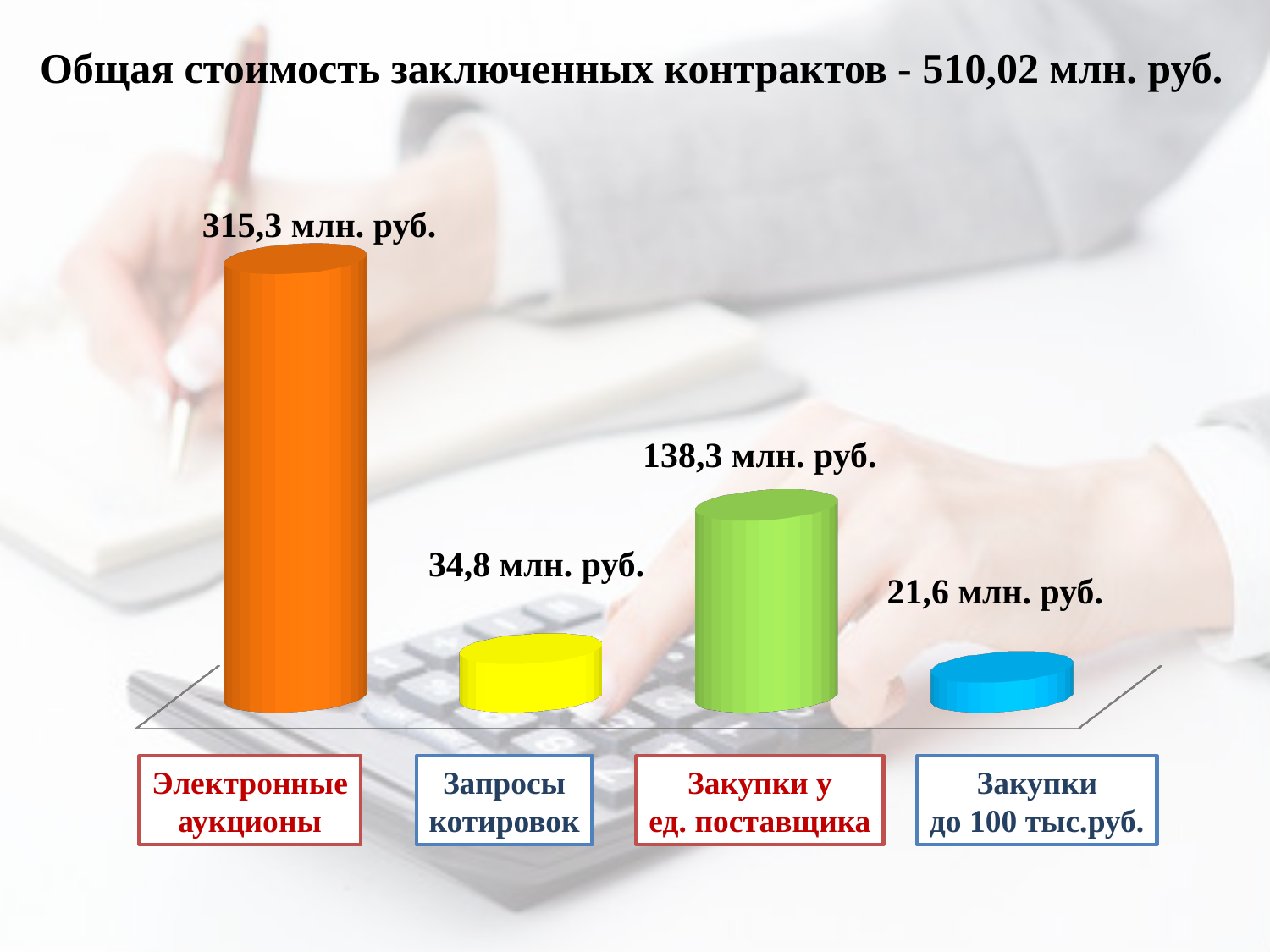
What is the value for Запросы котировок? 34,8 млн. руб. Which category has the highest value? Электронные аукционы What total value of concluded contracts is stated in the slide title? 510,02 млн. руб. What is the value for Электронные аукционы? 315,3 млн. руб. What is the value for Закупки до 100 тыс.руб.? 21,6 млн. руб. Which is larger, the value for Запросы котировок or the value for Закупки у ед. поставщика? Закупки у ед. поставщика What is the difference between the values for Электронные аукционы and Закупки у ед. поставщика? 177,0 млн. руб. What is the value for Закупки у ед. поставщика? 138,3 млн. руб. What is the difference between the values for Запросы котировок and Закупки до 100 тыс.руб.? 13,2 млн. руб. Which category has the lowest value? Закупки до 100 тыс.руб. What kind of chart is shown on the slide? Bar chart How many categories are shown in the chart? 4